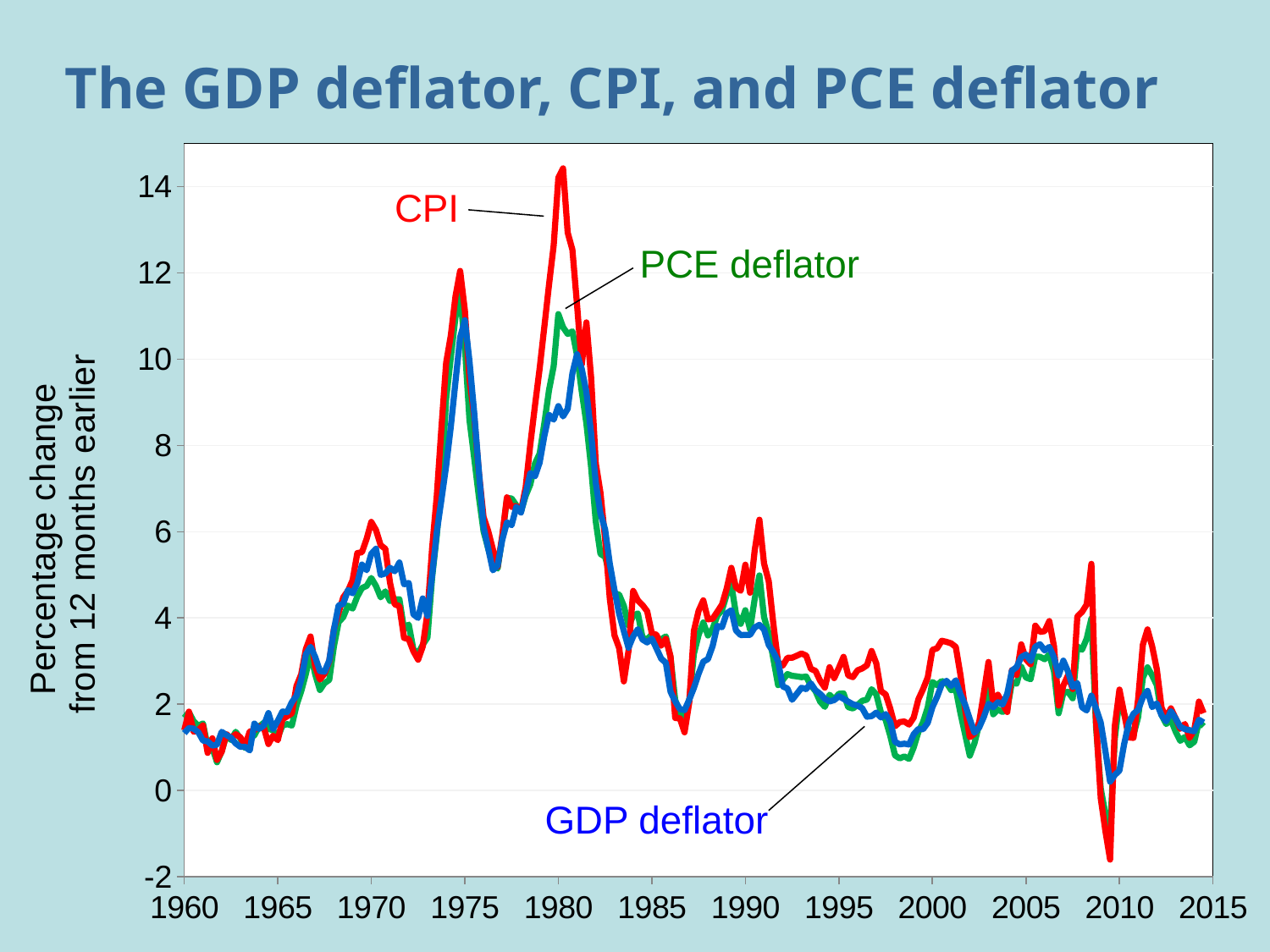
What kind of chart is shown on the slide? line chart What is the title of the chart? The GDP deflator, CPI, and PCE deflator What is the label on the vertical axis? Percentage change from 12 months earlier Which series reaches the lowest value on the chart? CPI Is the GDP deflator value in 1960 greater or less than 4? less How many series are plotted on the chart? 3 Do the values of the three series rise or fall between 1980 and 1985? fall Is the lowest CPI value around 2009 greater or less than 0? less Is the CPI value at its peak around 1980 greater or less than 12? greater Which series reaches the highest value on the chart? CPI Do the values of the three series rise or fall between 1965 and 1970? rise At the peak around 1980, which is higher, the CPI or the GDP deflator? CPI